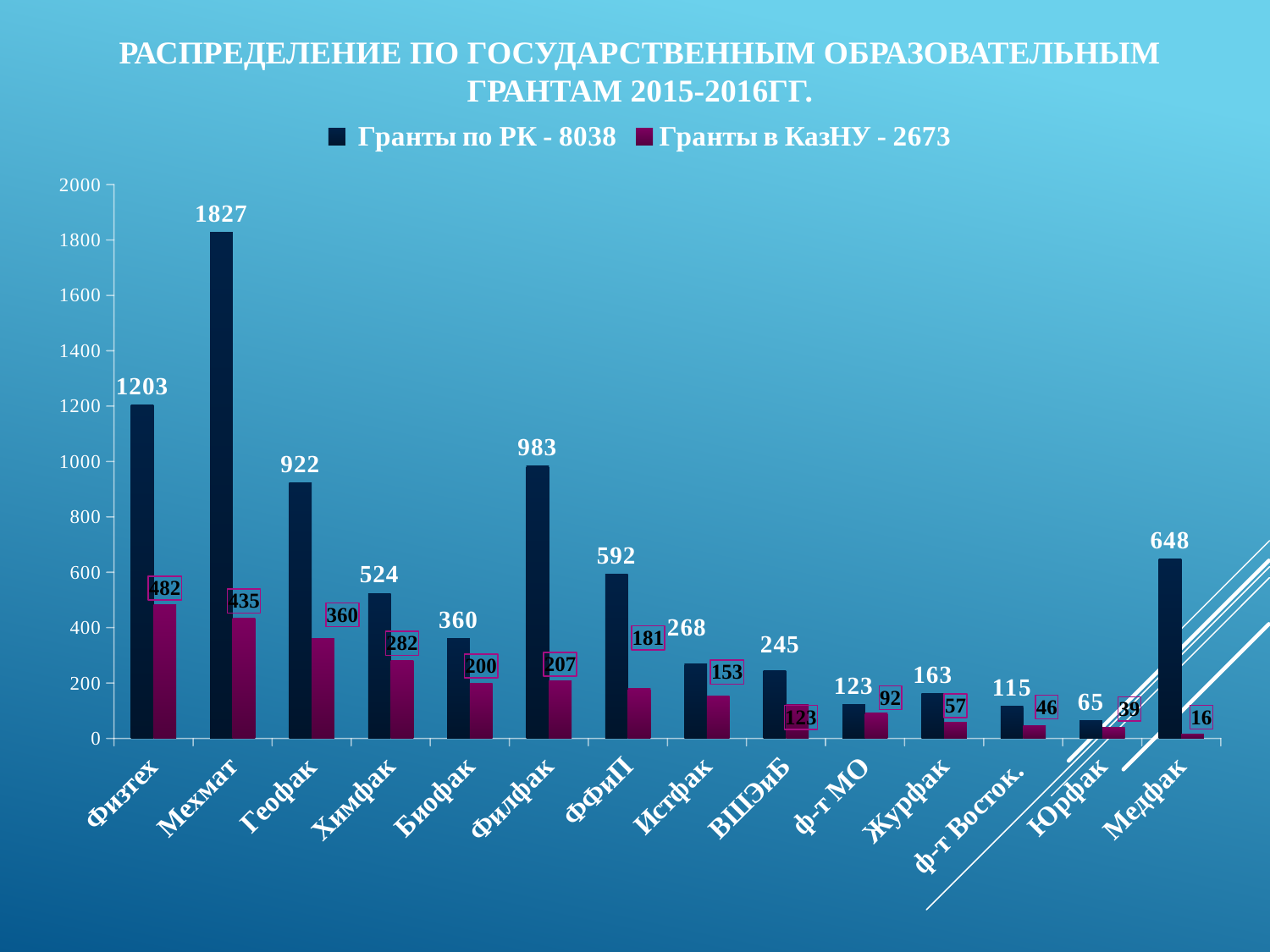
What is the value of Гранты в КазНУ for Медфак? 16 How many series does the legend list? 2 What is the value of Гранты в КазНУ for Физтех? 482 How many faculties are shown on the x axis? 14 Which has a larger Гранты по РК value, Геофак or Филфак? Филфак What is the difference between the Гранты по РК values for Мехмат and Физтех? 624 Which faculty has the highest value for Гранты по РК? Мехмат What kind of chart is shown on the slide? Bar chart Which faculty has the lowest value for Гранты по РК? Юрфак What is the difference between Гранты по РК and Гранты в КазНУ for Физтех? 721 Which faculty has the lowest value for Гранты в КазНУ? Медфак What is the value of Гранты по РК for Мехмат? 1827